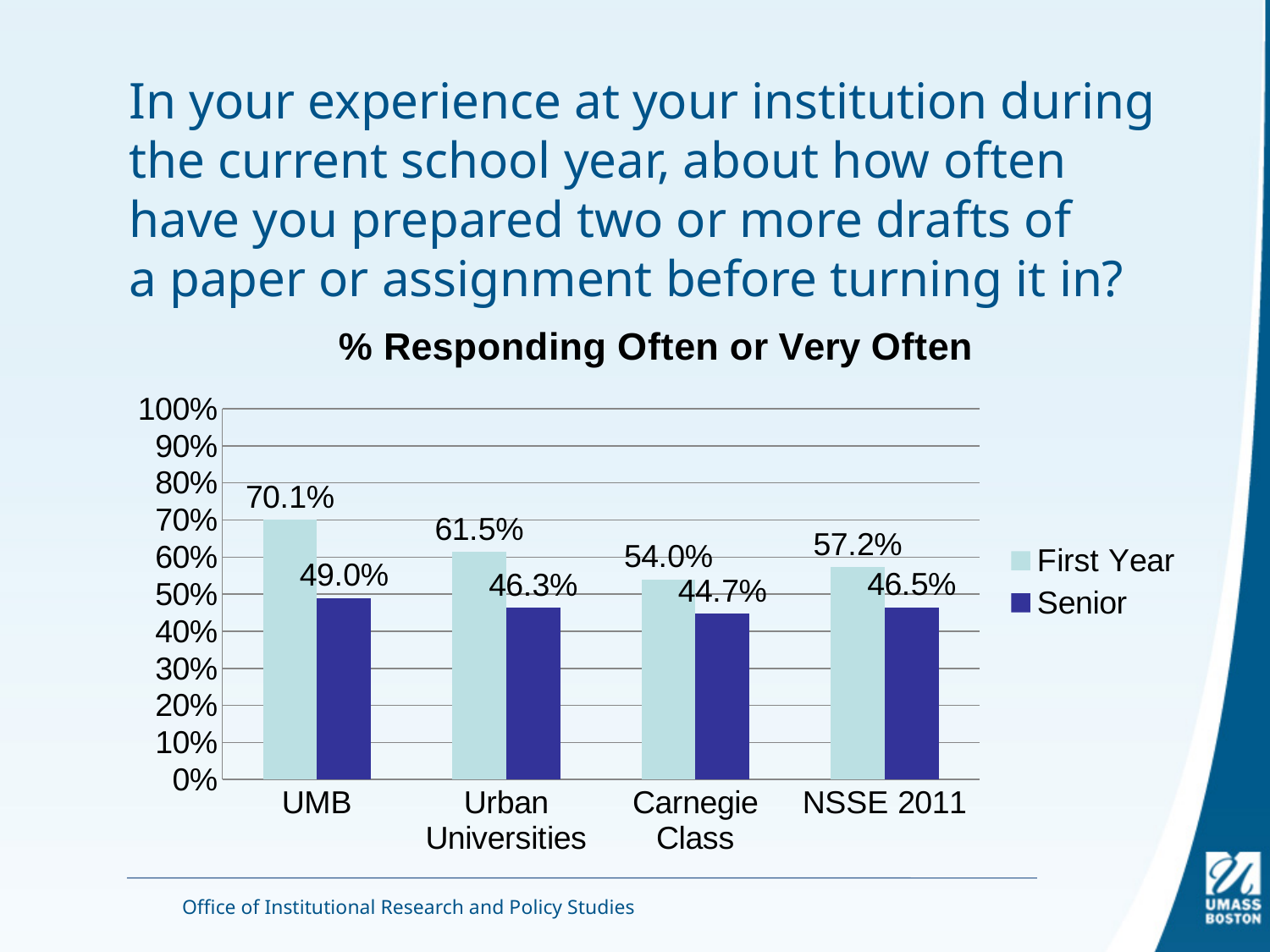
Which category has the highest First Year value? UMB What kind of chart is shown on the slide? bar chart What is the First Year value for UMB? 70.1% What is the Senior value for NSSE 2011? 46.5% How many series does the legend list? 2 Is the Senior value for Urban Universities greater or less than 50%? less What is the difference between the First Year and Senior values for UMB? 21.1% Which is larger, the First Year value for Urban Universities or the First Year value for NSSE 2011? Urban Universities Which category has the lowest Senior value? Carnegie Class What is the title of the chart? % Responding Often or Very Often How many categories are shown on the x axis? 4 What is the Senior value for Carnegie Class? 44.7%